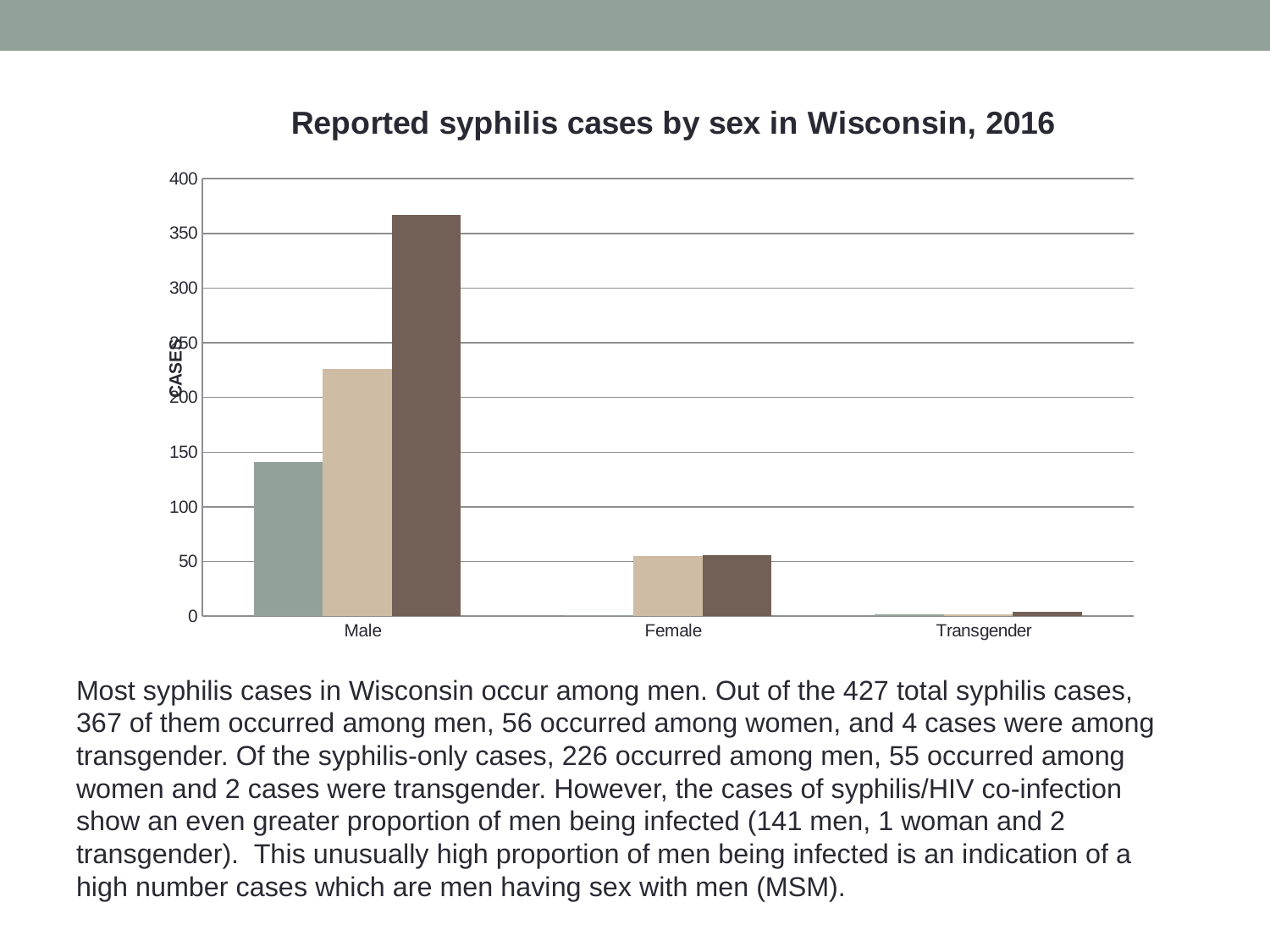
What is the title of the chart? Reported syphilis cases by sex in Wisconsin, 2016 What is the label on the vertical axis of the chart? CASES Is the tallest bar for Male greater or less than 350? greater Are the bars for Transgender greater or less than 50? less Is the tallest bar for Female greater or less than 100? less Which category has higher bars, Male or Female? Male Which category has the tallest bar in the chart? Male Which category has the lowest bars in the chart? Transgender What kind of chart is shown on the slide? bar chart How many categories are shown on the x axis of the chart? 3